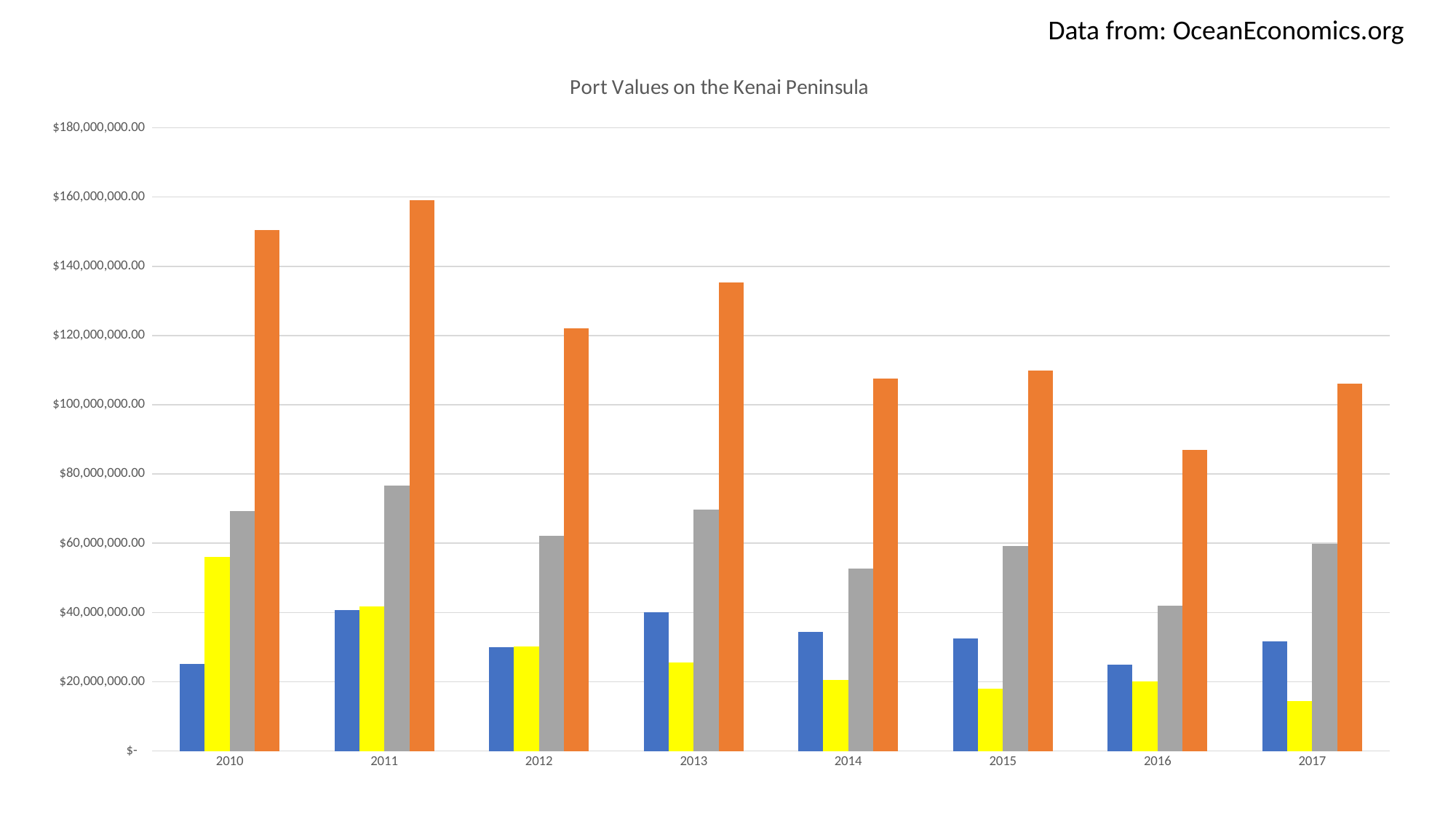
Which is larger, the orange bar for 2010 or the orange bar for 2012? 2010 In which year is the orange bar the shortest? 2016 How many years are shown along the x axis of the chart? 8 What is the title of the chart? Port Values on the Kenai Peninsula In which year is the yellow bar the shortest? 2017 What kind of chart is shown on the slide? bar chart In which year is the orange bar the tallest? 2011 Is the value of the orange bar for 2016 greater or less than $100,000,000.00? less In which year is the yellow bar the tallest? 2010 Is the value of the orange bar for 2011 greater or less than $140,000,000.00? greater How many bars (series) are plotted for each year in the chart? 4 Do the yellow bars generally rise or fall from 2010 to 2017? fall